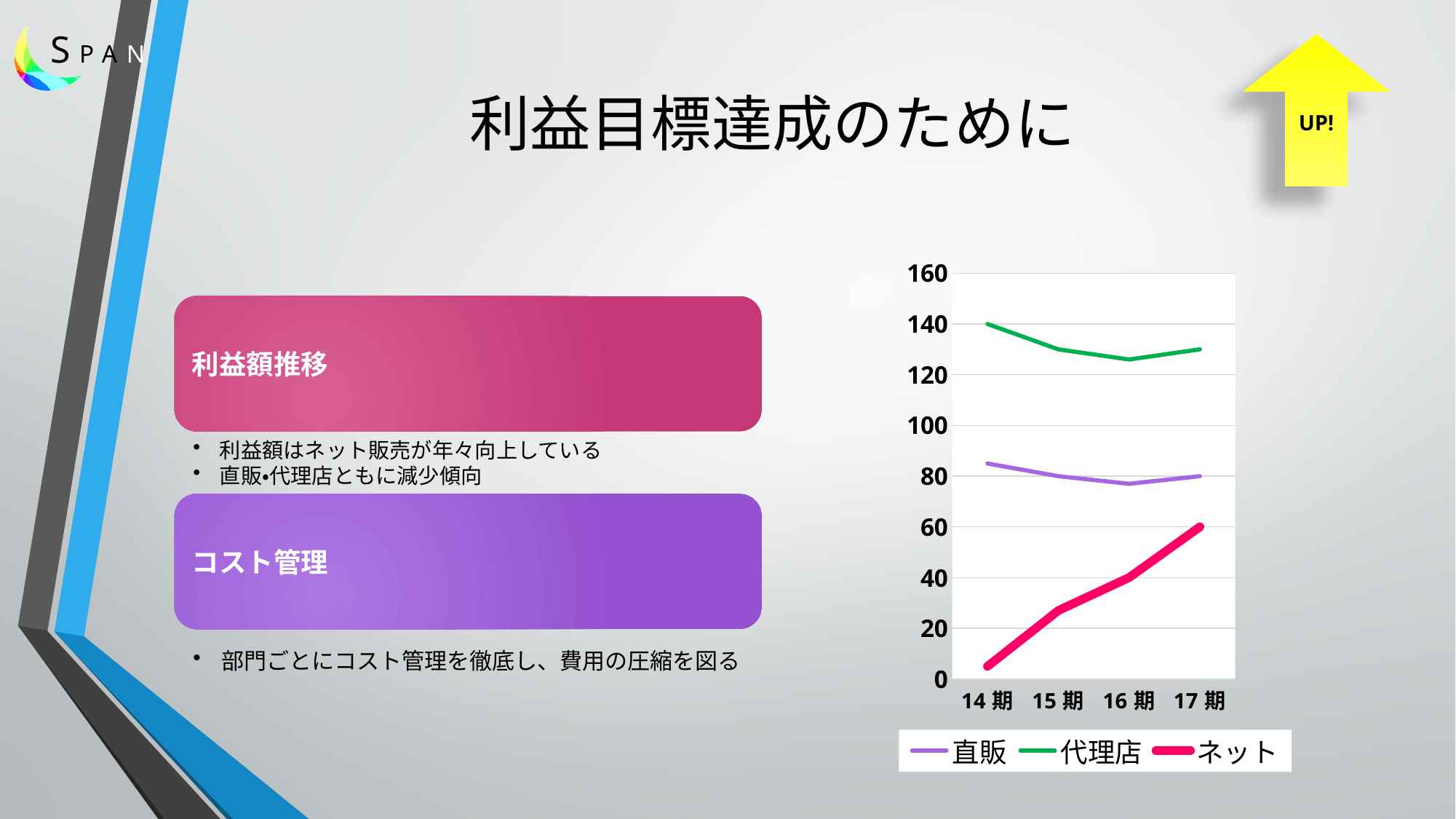
Is the value for 直販 at 14期 greater or less than 100? less Is the value for ネット at 15期 greater or less than 20? greater Which series has the lowest value at 14期? ネット How many series does the chart legend list? 3 Does the 代理店 line rise or fall from 14期 to 15期? fall What is the value for 代理店 at 14期? 140 At 16期, which is larger, 直販 or ネット? 直販 What colour is the ネット line in the chart? pink How many periods are shown on the x axis of the chart? 4 What kind of chart is shown on the slide? line chart Does the ネット line rise or fall from 14期 to 17期? rise Which series has the highest value at 17期? 代理店